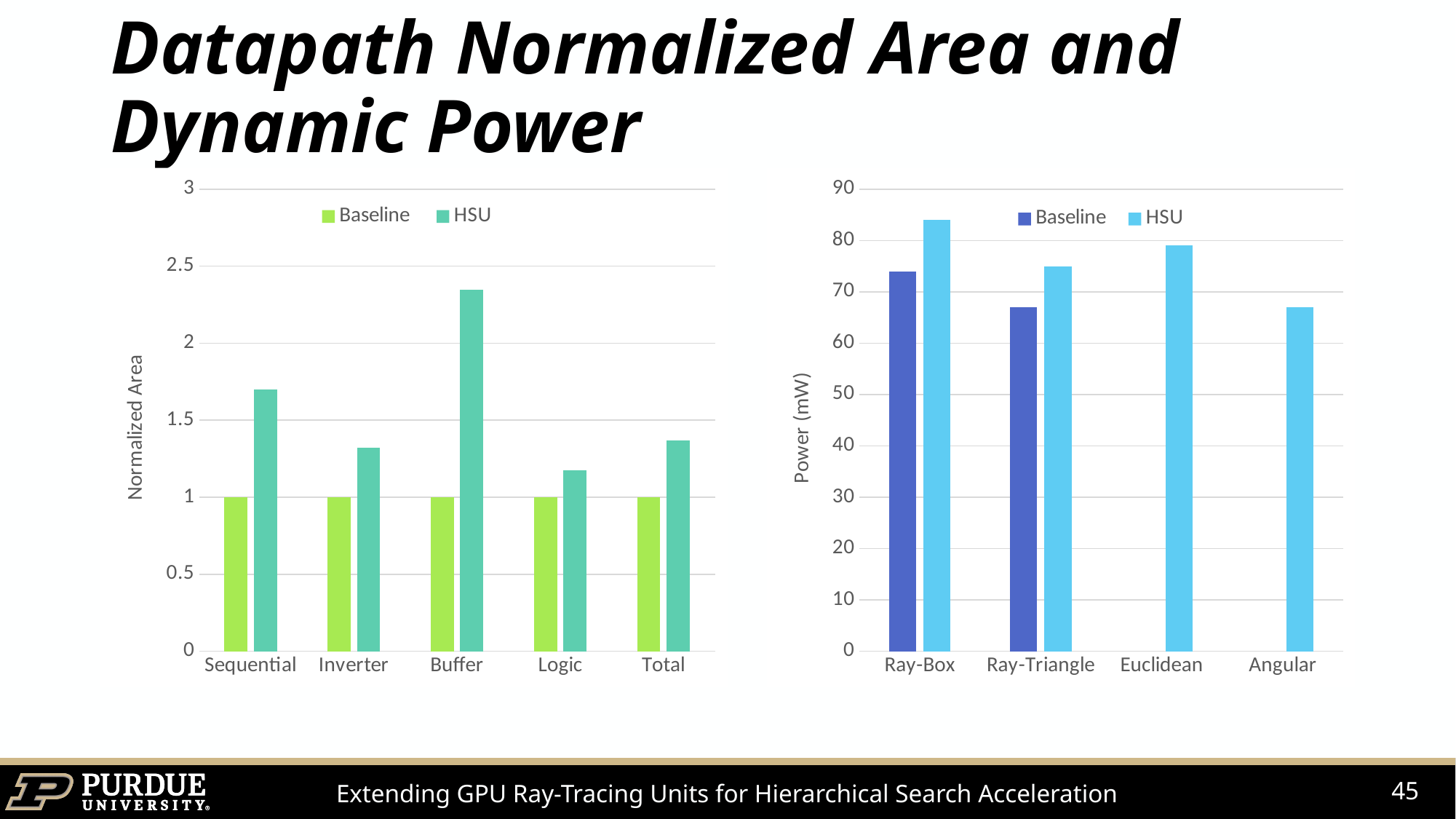
In the Power (mW) chart on the right, is the HSU value for Euclidean greater or less than 70? greater In the Power (mW) chart on the right, which is larger for Ray-Triangle, the Baseline value or the HSU value? HSU In the Normalized Area chart on the left, is the HSU value for Inverter greater or less than 1.5? less How many series does the legend of the Normalized Area chart on the left list? 2 In the Normalized Area chart on the left, which category has the highest HSU value? Buffer How many categories are shown on the x axis of the Normalized Area chart on the left? 5 In the Power (mW) chart on the right, which category has the highest HSU value? Ray-Box In the Normalized Area chart on the left, is the HSU value for Sequential greater or less than 1.5? greater In the Normalized Area chart on the left, what is the Baseline value for Buffer? 1 What is the y-axis label of the chart on the right? Power (mW) In the Normalized Area chart on the left, which category has the lowest HSU value? Logic What kind of chart is the Power (mW) chart on the right? bar chart